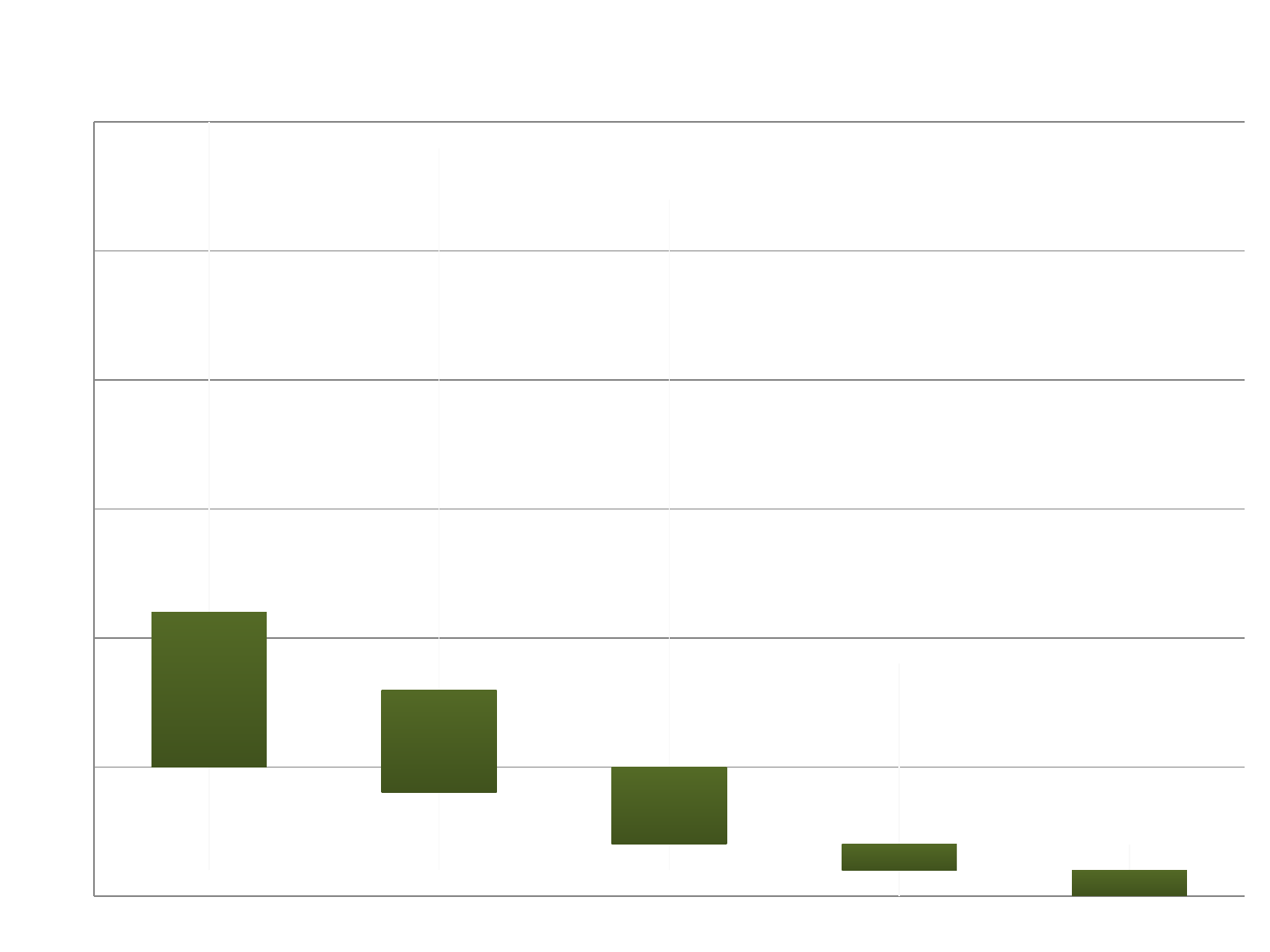
What colour are the bars in the chart? green What kind of chart is shown on the slide? bar chart Do the bars rise or fall from left to right along the x axis? fall How many bars are plotted in the chart? 5 Which bar is the tallest: the leftmost or the rightmost? leftmost Does the chart show a legend? no